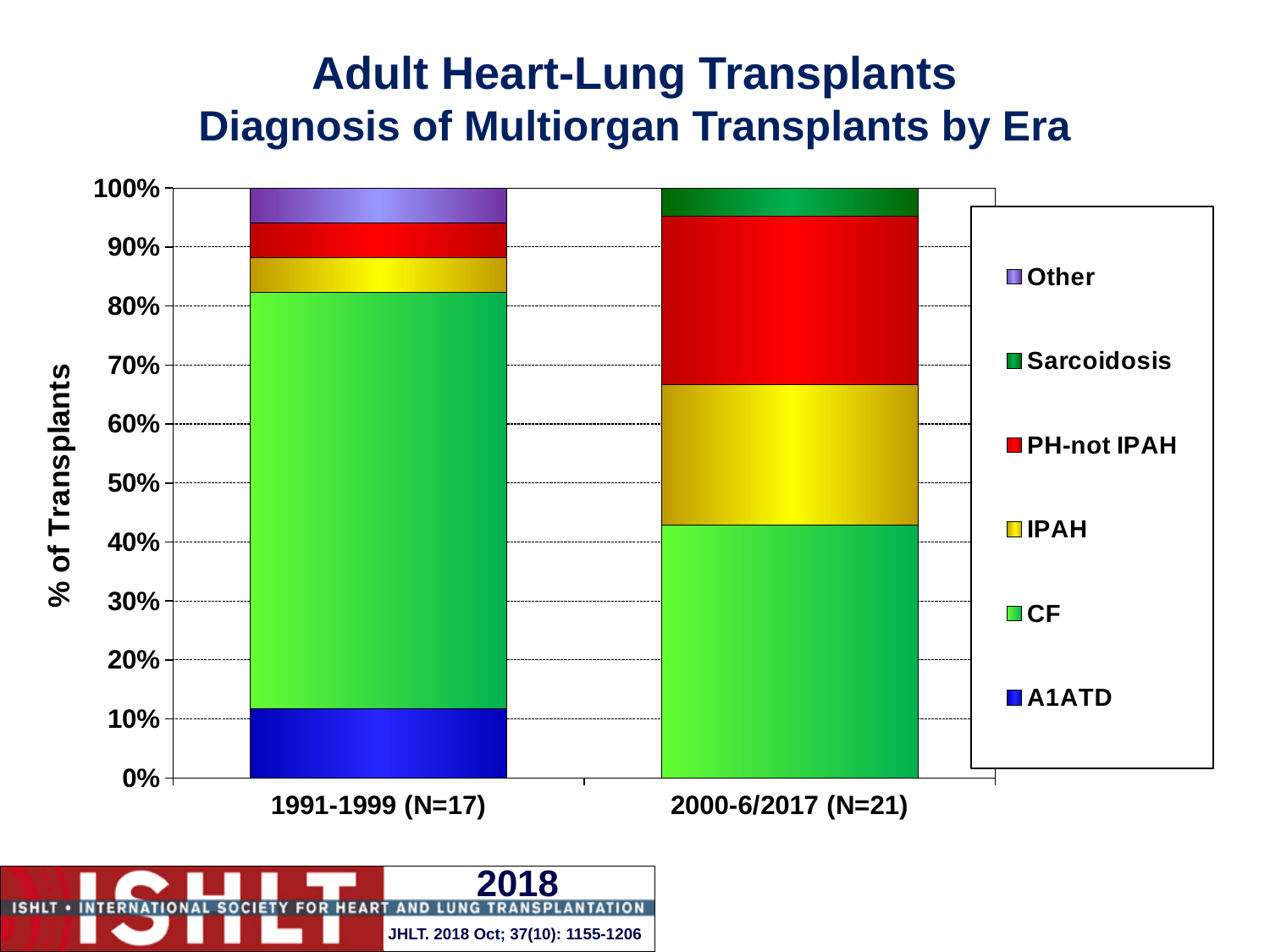
In which era is the CF share larger, 1991-1999 (N=17) or 2000-6/2017 (N=21)? 1991-1999 (N=17) Which diagnosis makes up the largest share of the 2000-6/2017 (N=21) bar? CF Is the CF share for 2000-6/2017 (N=21) greater or less than 50%? less Is the A1ATD share for 1991-1999 (N=17) greater or less than 20%? less Is the CF share for 1991-1999 (N=17) greater or less than 60%? greater How many eras (categories) are shown on the x axis? 2 What value does the top of each stacked bar reach on the y axis? 100% How many diagnosis series does the legend list? 6 Which diagnosis makes up the largest share of the 1991-1999 (N=17) bar? CF What is the title of the y axis? % of Transplants What kind of chart is shown on the slide? Stacked bar chart In which era is the PH-not IPAH share larger, 1991-1999 (N=17) or 2000-6/2017 (N=21)? 2000-6/2017 (N=21)